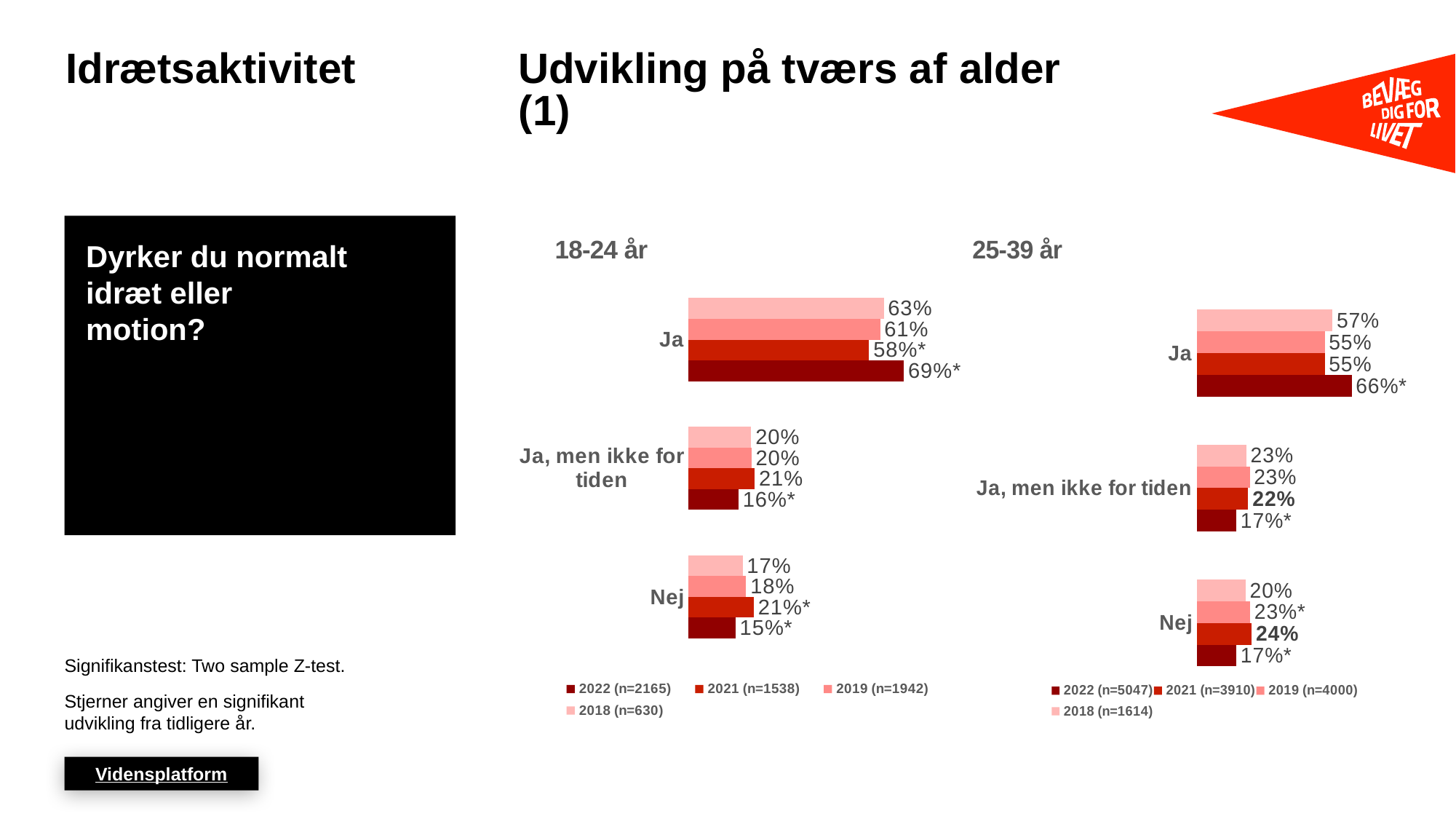
In the 25-39 år chart, what is the 2022 value for Nej? 17%* What kind of chart is the 25-39 år chart? Bar chart In the 18-24 år chart, what is the 2018 value for Ja? 63% How many categories are shown in the 18-24 år chart? 3 How many series does the legend of the 25-39 år chart list? 4 In the 18-24 år chart, what is the 2022 value for Ja? 69%* In the 25-39 år chart, what is the difference between the 2022 and 2018 values for Ja? 9 percentage points In the 18-24 år chart, which year has the lowest value for Nej? 2022 In the 18-24 år chart, which is larger for Ja, men ikke for tiden: the 2021 value or the 2022 value? 2021 What sample size is given for 2022 in the legend of the 18-24 år chart? n=2165 In the 18-24 år chart, which year has the highest value for Ja? 2022 In the 25-39 år chart, what is the 2021 value for Ja, men ikke for tiden? 22%